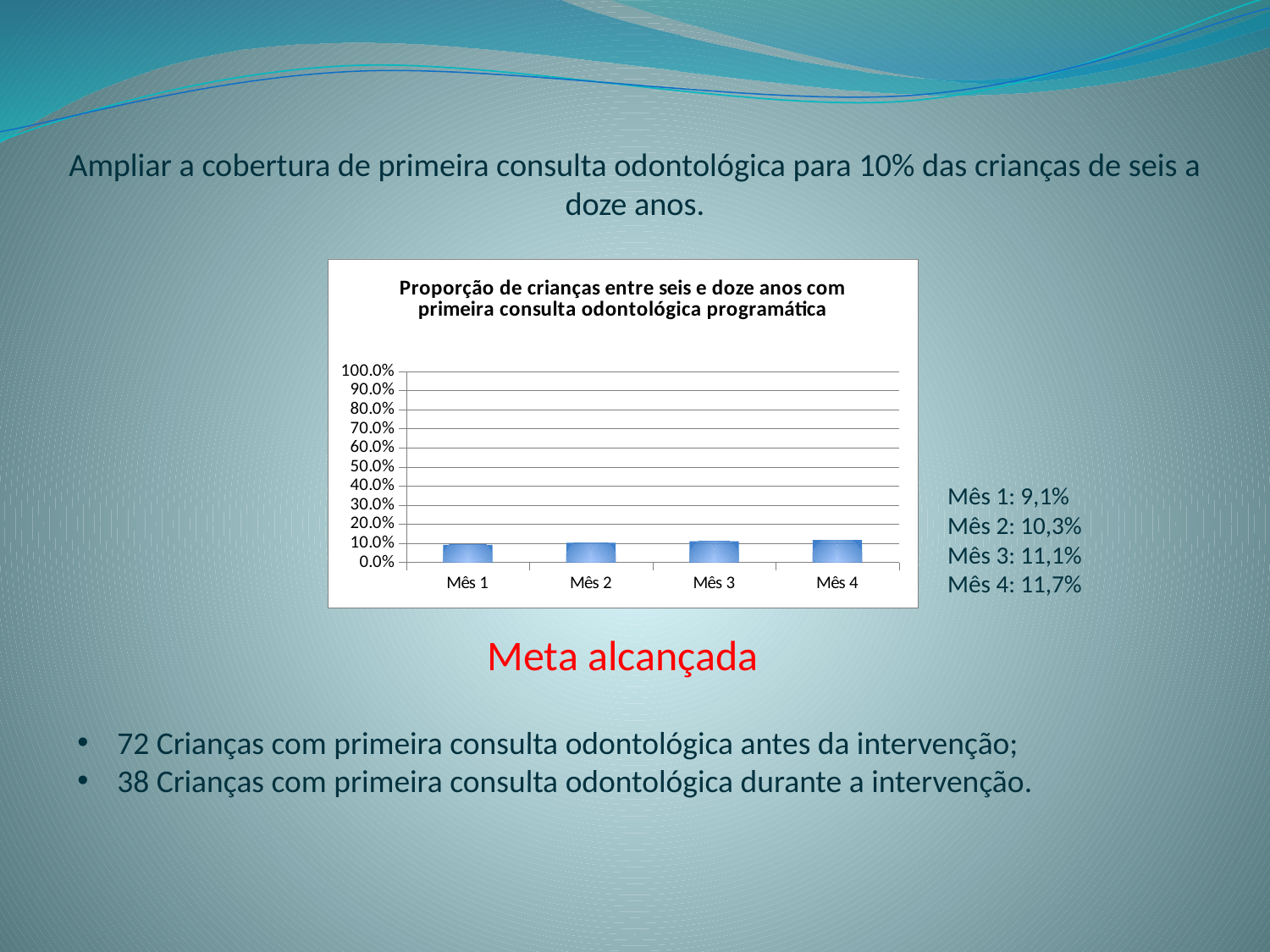
Do the values rise or fall from Mês 1 to Mês 4? rise Is the value for Mês 4 greater or less than 20.0%? less What is the value for Mês 4? 11,7% What kind of chart is shown on the slide? bar chart What is the value for Mês 3? 11,1% Which is larger, the value for Mês 3 or the value for Mês 2? Mês 3 How many months (categories) are plotted on the x axis of the chart? 4 What is the value for Mês 2? 10,3% What is the difference between the values for Mês 4 and Mês 1? 2,6% What is the value for Mês 1? 9,1% Which month has the lowest proportion? Mês 1 Which month has the highest proportion? Mês 4